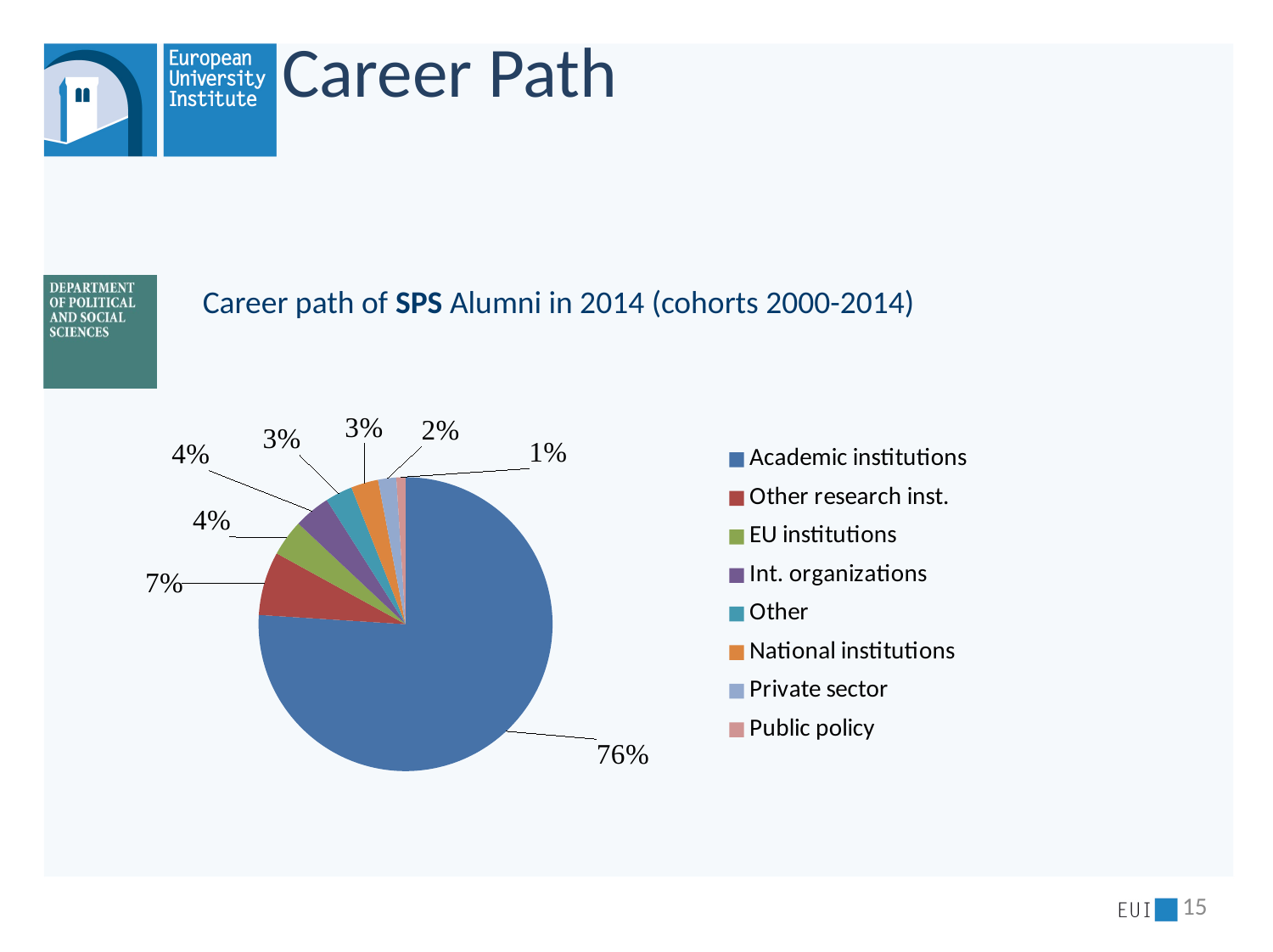
Which career category has the largest share of SPS alumni? Academic institutions What share of the pie is labelled for EU institutions? 4% Which career category has the smallest share of SPS alumni? Public policy What percentage of SPS alumni are in the private sector? 2% Which is larger: the share for Other research inst. or the share for National institutions? Other research inst. What is the title text above the pie chart? Career path of SPS Alumni in 2014 (cohorts 2000-2014) How many career categories are shown in the pie chart? 8 How many percentage points larger is the academic institutions share than the other research institutions share? 69 percentage points How many entries does the legend list? 8 What percentage of SPS alumni work in other research institutions? 7% What type of chart is shown on the slide? Pie chart What share of SPS alumni are in academic institutions? 76%